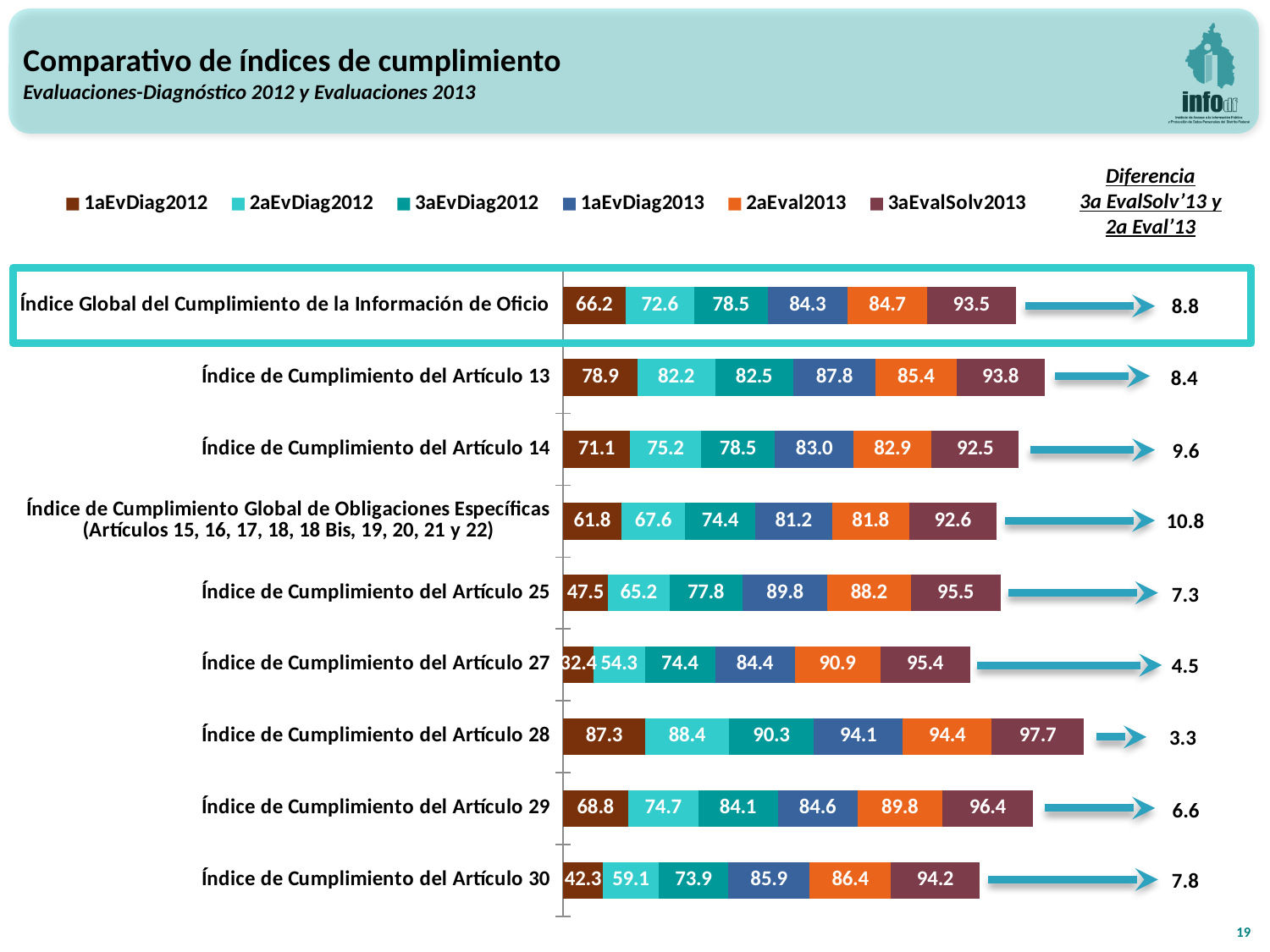
What is the 1aEvDiag2012 value for Índice de Cumplimiento del Artículo 30? 42.3 What kind of chart is shown on the slide? Stacked bar chart What is the 3aEvalSolv2013 value for Índice de Cumplimiento del Artículo 28? 97.7 What is the 2aEval2013 value for Índice Global del Cumplimiento de la Información de Oficio? 84.7 For Índice de Cumplimiento del Artículo 30, do the values rise or fall from 1aEvDiag2012 through 3aEvalSolv2013? Rise For Índice de Cumplimiento del Artículo 14, what is the difference between the 3aEvalSolv2013 value and the 2aEval2013 value? 9.6 Which category has the lowest 1aEvDiag2012 value? Índice de Cumplimiento del Artículo 27 How many categories (indices) are shown in the chart? 9 Which category has the highest 3aEvalSolv2013 value? Índice de Cumplimiento del Artículo 28 For Índice de Cumplimiento del Artículo 25, which is larger: the 1aEvDiag2013 value or the 2aEval2013 value? 1aEvDiag2013 What is the Diferencia 3a EvalSolv'13 y 2a Eval'13 value shown for Índice de Cumplimiento del Artículo 27? 4.5 How many series does the legend list? 6